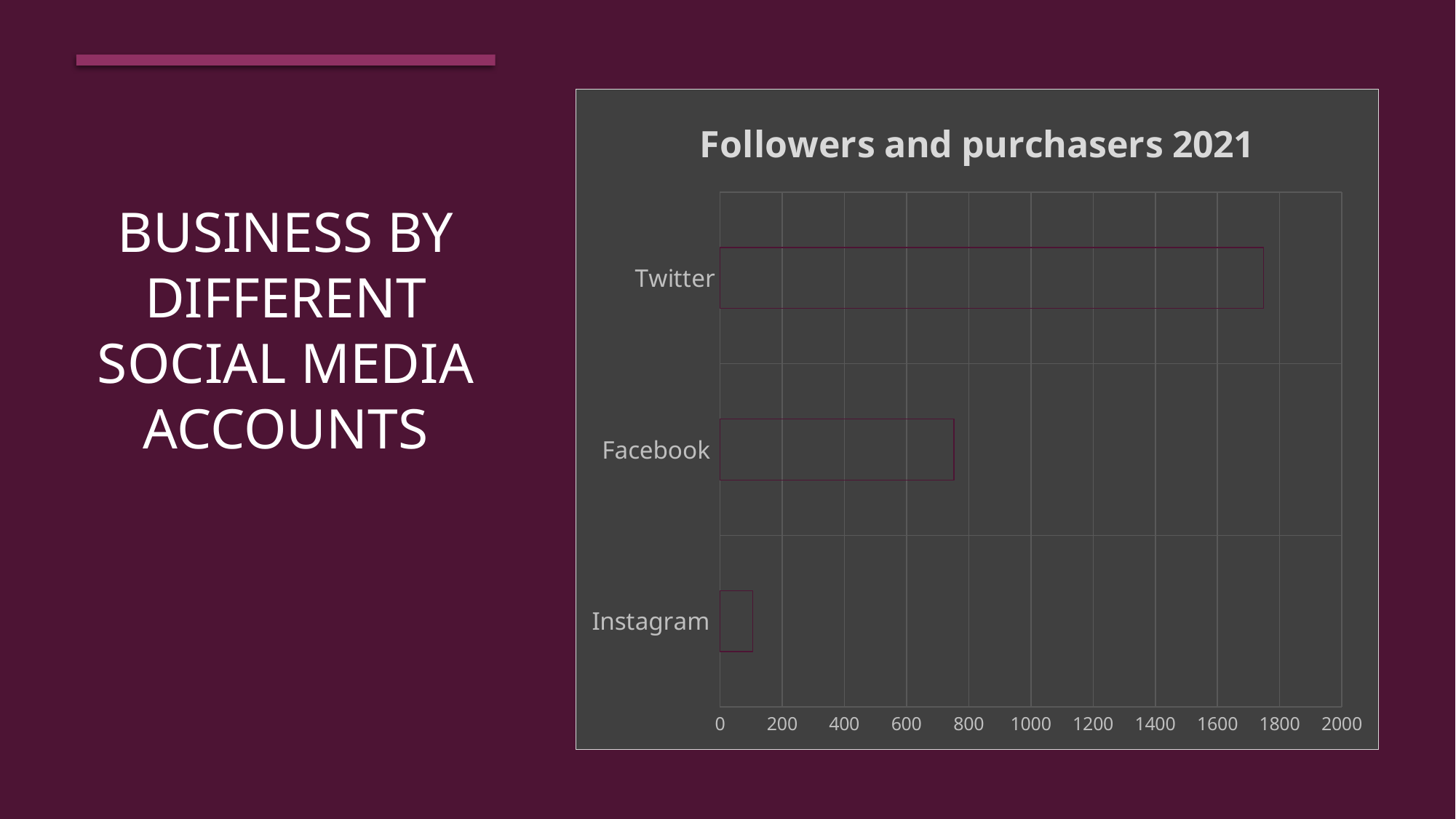
Which has a larger value, Facebook or Instagram? Facebook Is the value for Facebook greater or less than 600? greater Is the value for Twitter greater or less than 1800? less Is the value for Twitter greater or less than 1600? greater Which social media account has the lowest value in the chart? Instagram Which has a larger value, Twitter or Facebook? Twitter What is the title of the chart? Followers and purchasers 2021 What kind of chart is shown on the slide? bar chart Which social media account has the highest value in the chart? Twitter How many social media accounts are plotted in the chart? 3